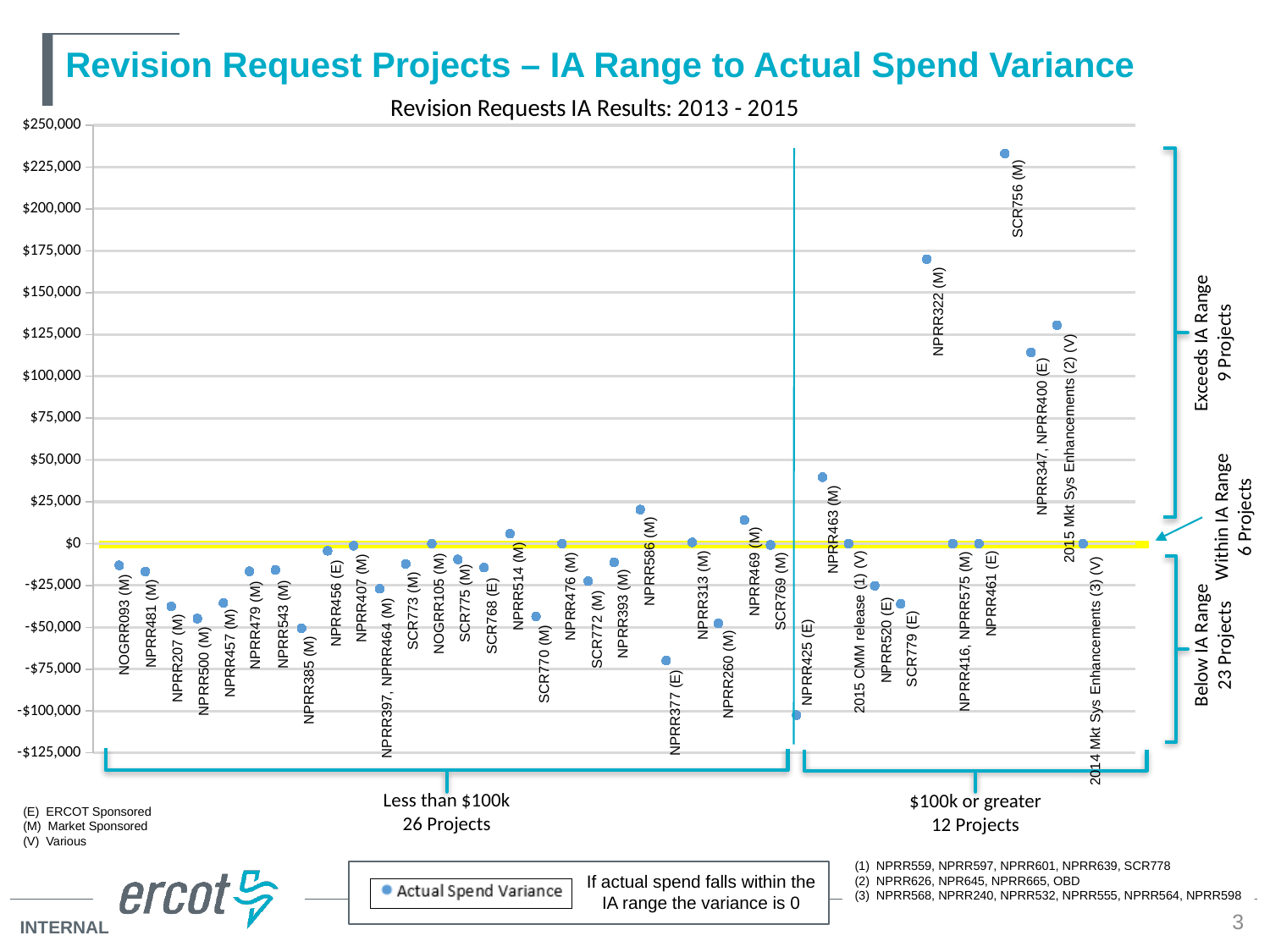
How many projects are in the 'Less than $100k' group according to the chart annotation? 26 Projects Is the value for SCR756 (M) greater or less than $200,000? greater Is the value for NPRR377 (E) greater or less than -$50,000? less Which has the larger actual spend variance, NPRR463 (M) or NPRR586 (M)? NPRR463 (M) Which has the larger actual spend variance, NPRR322 (M) or SCR756 (M)? SCR756 (M) What kind of chart is shown on the slide? scatter chart Is the value for NPRR322 (M) greater or less than $150,000? greater How many series does the chart legend list? 1 What is the title of the chart? Revision Requests IA Results: 2013 - 2015 What is the name of the series shown in the legend? Actual Spend Variance How many projects are marked as 'Exceeds IA Range' on the chart? 9 Projects Which project has the highest actual spend variance on the chart? SCR756 (M)